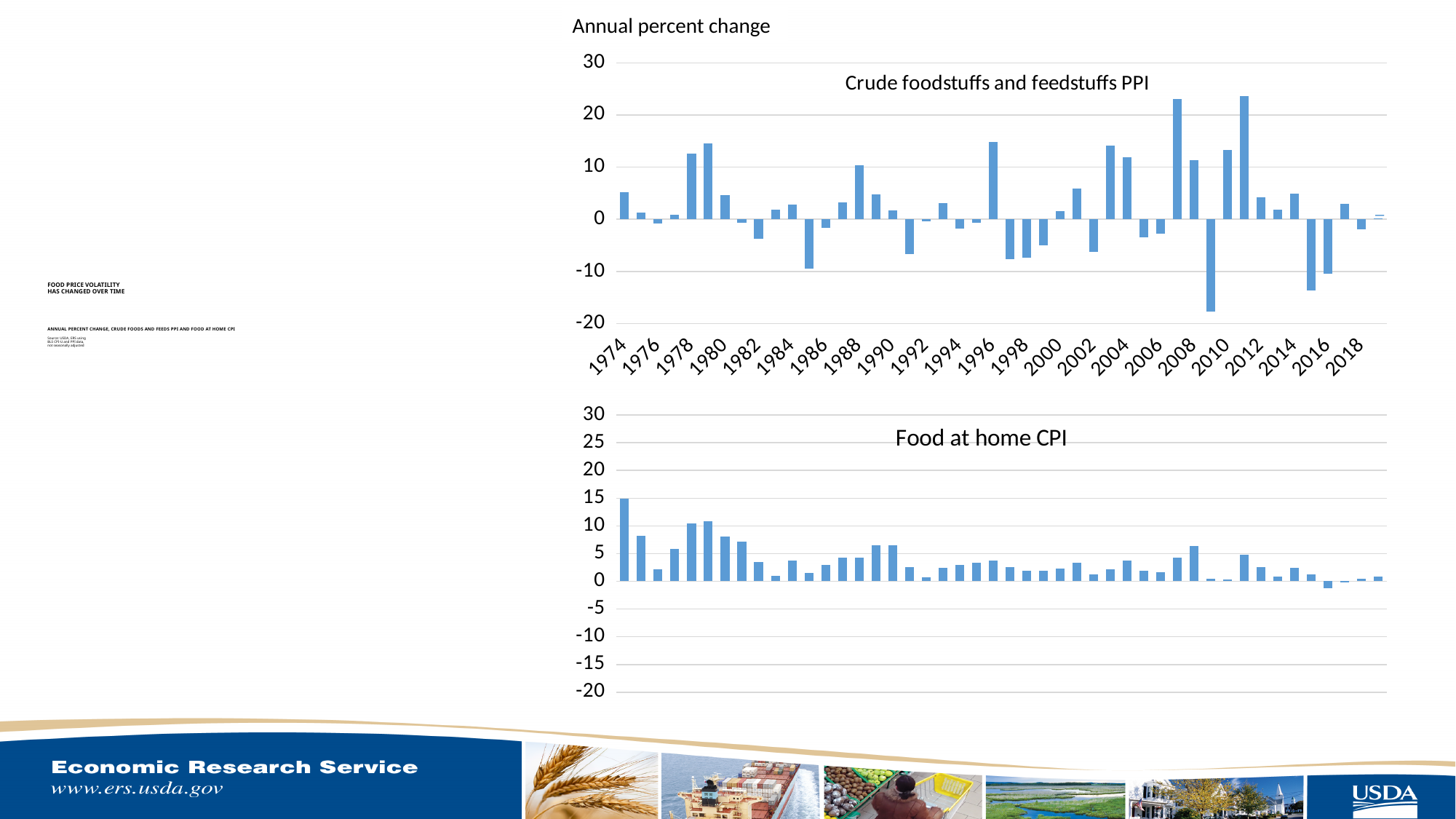
In the 'Crude foodstuffs and feedstuffs PPI' chart, which is larger, the value for 1996 or the value for 1997? 1996 In the 'Food at home CPI' chart, do the values generally rise or fall from left to right? fall What kind of chart is the 'Crude foodstuffs and feedstuffs PPI' chart? bar chart In the 'Crude foodstuffs and feedstuffs PPI' chart, is the value for 2009 greater or less than -10? less In the 'Crude foodstuffs and feedstuffs PPI' chart, is the value for 2008 greater or less than 20? less In the 'Crude foodstuffs and feedstuffs PPI' chart, which year has the lowest value? 2009 In the 'Food at home CPI' chart, is the value of the leftmost bar greater or less than 10? greater What label is shown above the charts describing the y-axis measure? Annual percent change What is the title of the lower chart? Food at home CPI How many charts are shown on the slide? 2 In the 'Crude foodstuffs and feedstuffs PPI' chart, what is the first year shown on the x-axis? 1974